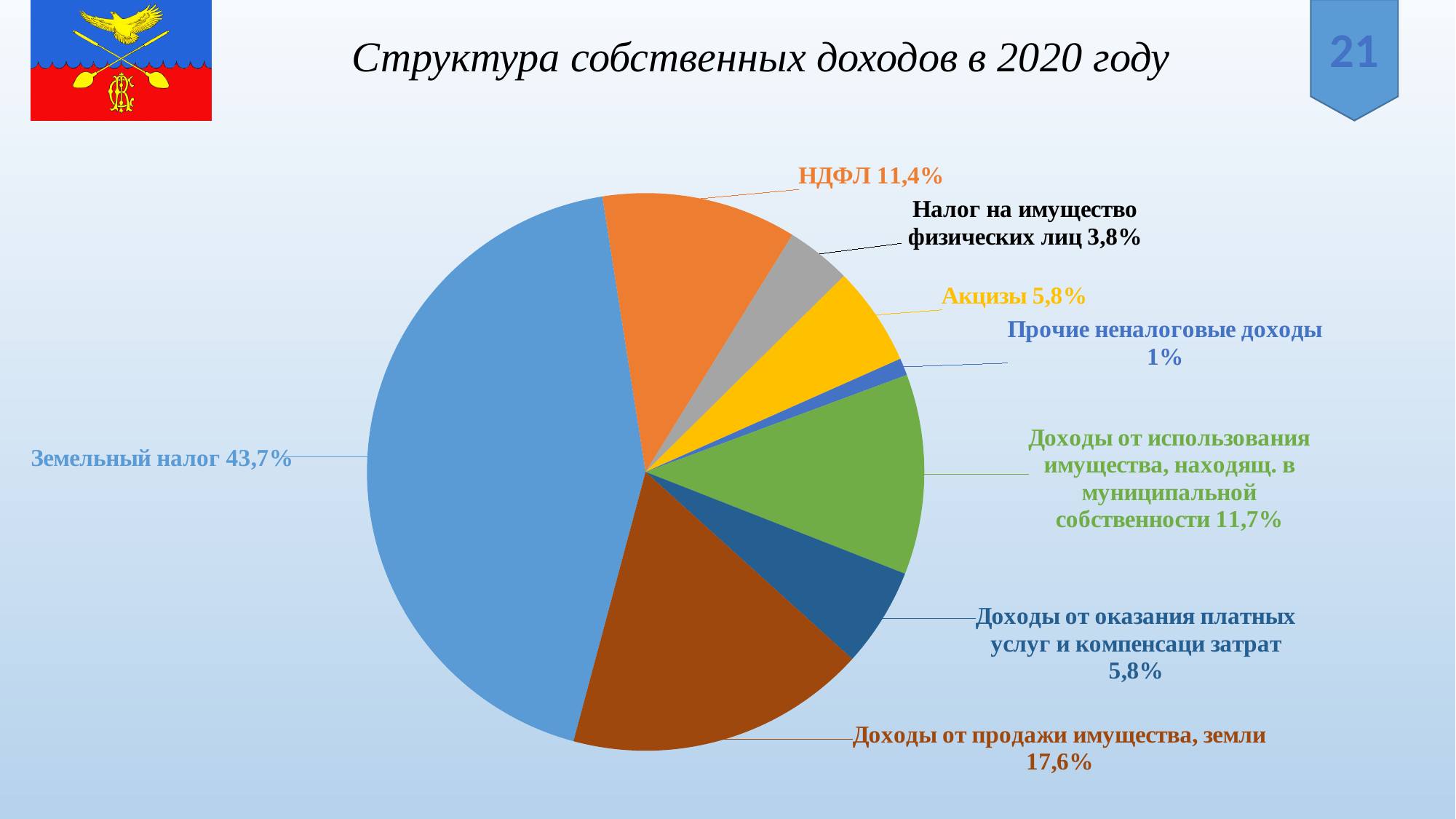
What is the value shown for Налог на имущество физических лиц? 3,8% What is the title of the chart on the slide? Структура собственных доходов в 2020 году Which category has the largest share of the pie? Земельный налог What is the difference between the shares of Земельный налог and Доходы от продажи имущества, земли? 26,1% What is the value shown for НДФЛ? 11,4% What is the value shown for Доходы от продажи имущества, земли? 17,6% How many slices does the pie chart have? 8 Which is larger: the share of НДФЛ or the share of Акцизы? НДФЛ Which category has the smallest share of the pie? Прочие неналоговые доходы What colour is the slice for Доходы от использования имущества, находящ. в муниципальной собственности? green What share of the pie does Земельный налог have? 43,7% What type of chart is shown on the slide? pie chart